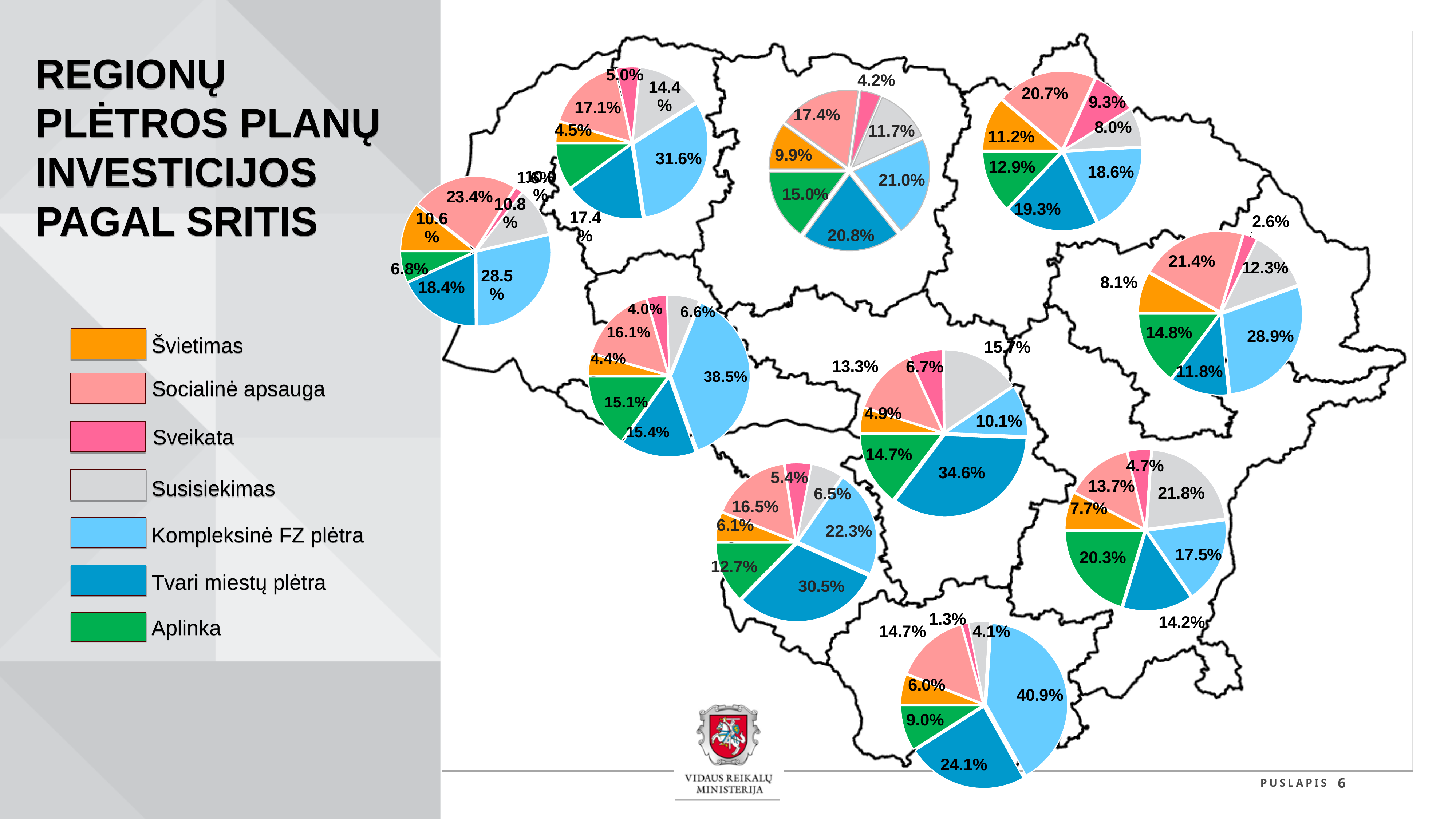
In the pie chart at the bottom of the map, what share does Kompleksinė FZ plėtra (light blue) have? 40.9% In the pie chart in the centre of the map (with the 34.6% slice), which category has the largest share? Tvari miestų plėtra In the pie chart on the right side of the map (with the 28.9% slice), what is the share for Sveikata (pink)? 2.6% In the pie chart at the bottom of the map, which category has the smallest share? Sveikata In the pie chart at the lower right of the map (with the 21.8% slice), what is the share for Aplinka (green)? 20.3% In the pie chart at the top right of the map (with the 20.7% slice), which is larger: Tvari miestų plėtra or Kompleksinė FZ plėtra? Tvari miestų plėtra In the pie chart at the top centre of the map, what is the difference between the Kompleksinė FZ plėtra share (21.0%) and the Tvari miestų plėtra share (20.8%)? 0.2% What type of charts are shown on the map? Pie charts How many categories does the legend on the left of the slide list? 7 In the pie chart at the lower left of the map (with the 30.5% slice), what is the share for Socialinė apsauga? 16.5% In the pie chart in the centre of the map (with the 34.6% slice), what is the share for Susisiekimas (grey)? 15.7% In the pie chart at the top centre of the map (with the 21.0% slice), what is the share for Aplinka (green)? 15.0%